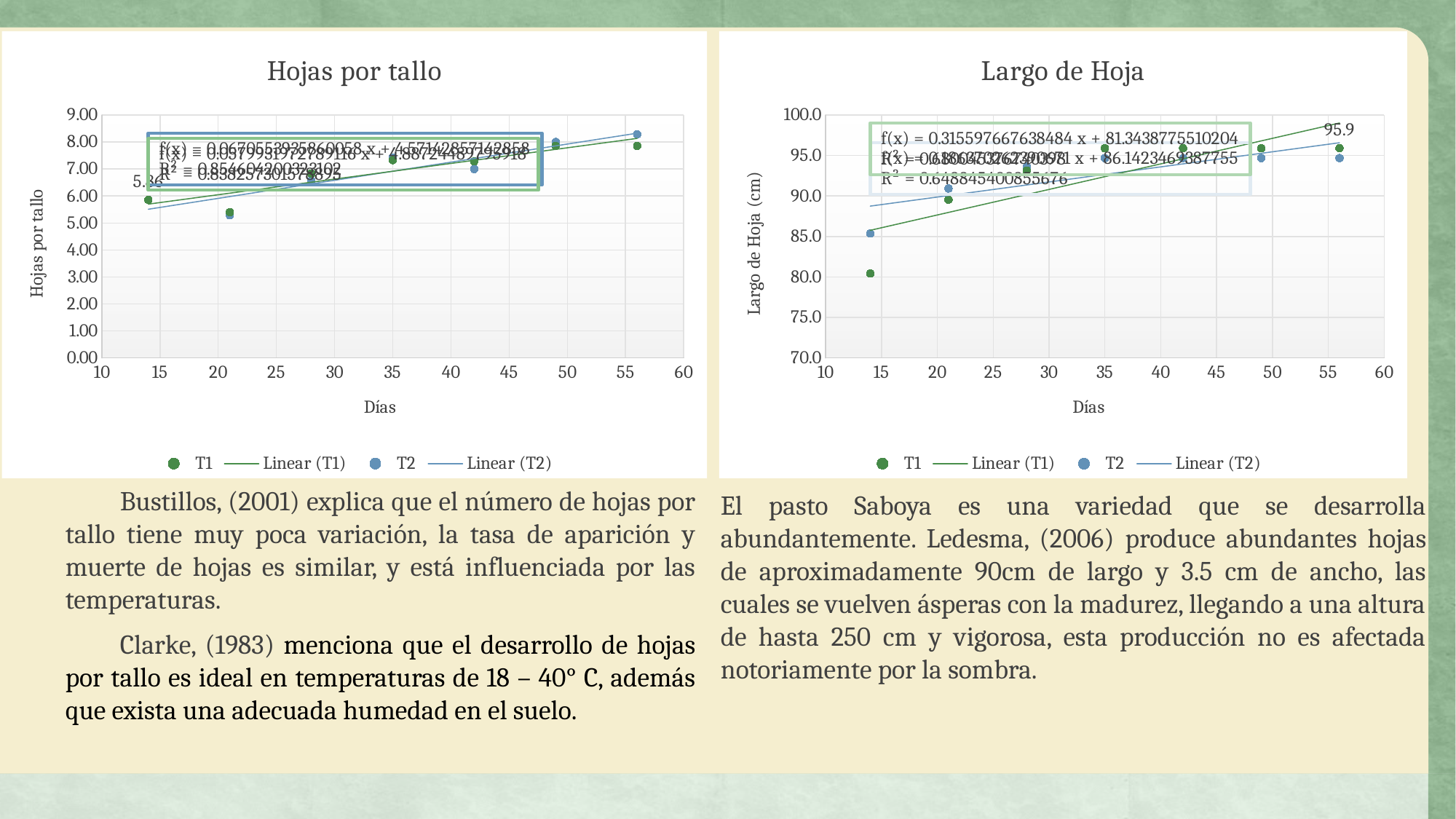
How many entries does the legend of the 'Largo de Hoja' chart list? 4 In the 'Largo de Hoja' chart, is the T2 value at day 14 greater or less than 90.0? less How many data points does the T1 series have in the 'Hojas por tallo' chart? 7 In the 'Largo de Hoja' chart, do the T1 values generally rise or fall as the days increase? rise What is the x-axis label of the 'Hojas por tallo' chart? Días What kind of chart is the 'Hojas por tallo' chart? scatter chart In the 'Largo de Hoja' chart, is the T1 value at day 14 greater or less than 85.0? less In the 'Hojas por tallo' chart, is the T2 value at day 21 greater or less than 6.00? less In the 'Largo de Hoja' chart, what is the labelled value of the T1 point at day 56? 95.9 In the 'Largo de Hoja' chart, at day 14, which series has the larger value, T1 or T2? T2 In the 'Largo de Hoja' chart, at which day does the T1 series have its lowest value? 14